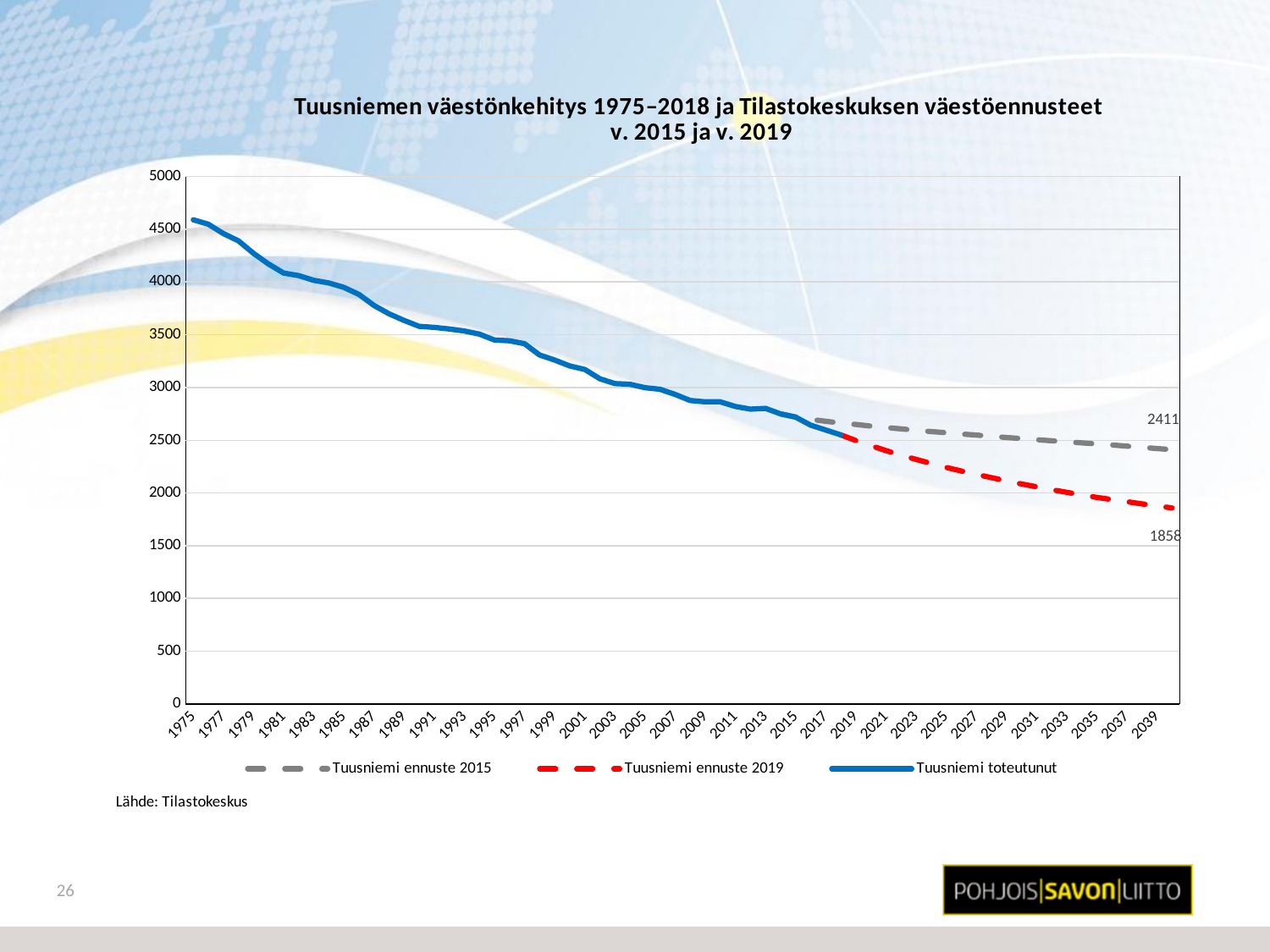
How many series does the legend list? 3 Is the Tuusniemi toteutunut value for 1975 greater or less than 4500? greater What source is cited below the chart? Tilastokeskus What is the final labelled value of the Tuusniemi ennuste 2015 series? 2411 What kind of chart is shown on the slide? line chart What is the final labelled value of the Tuusniemi ennuste 2019 series? 1858 Which forecast series ends at a higher value, Tuusniemi ennuste 2015 or Tuusniemi ennuste 2019? Tuusniemi ennuste 2015 Is the Tuusniemi toteutunut value for 1995 greater or less than 3000? greater What is the difference between the final labelled values of the 2015 forecast (2411) and the 2019 forecast (1858)? 553 Does the Tuusniemi toteutunut series rise or fall from 1975 to 2018? fall Which series is drawn as a solid blue line? Tuusniemi toteutunut Is the Tuusniemi ennuste 2019 value for 2031 greater or less than 2500? less